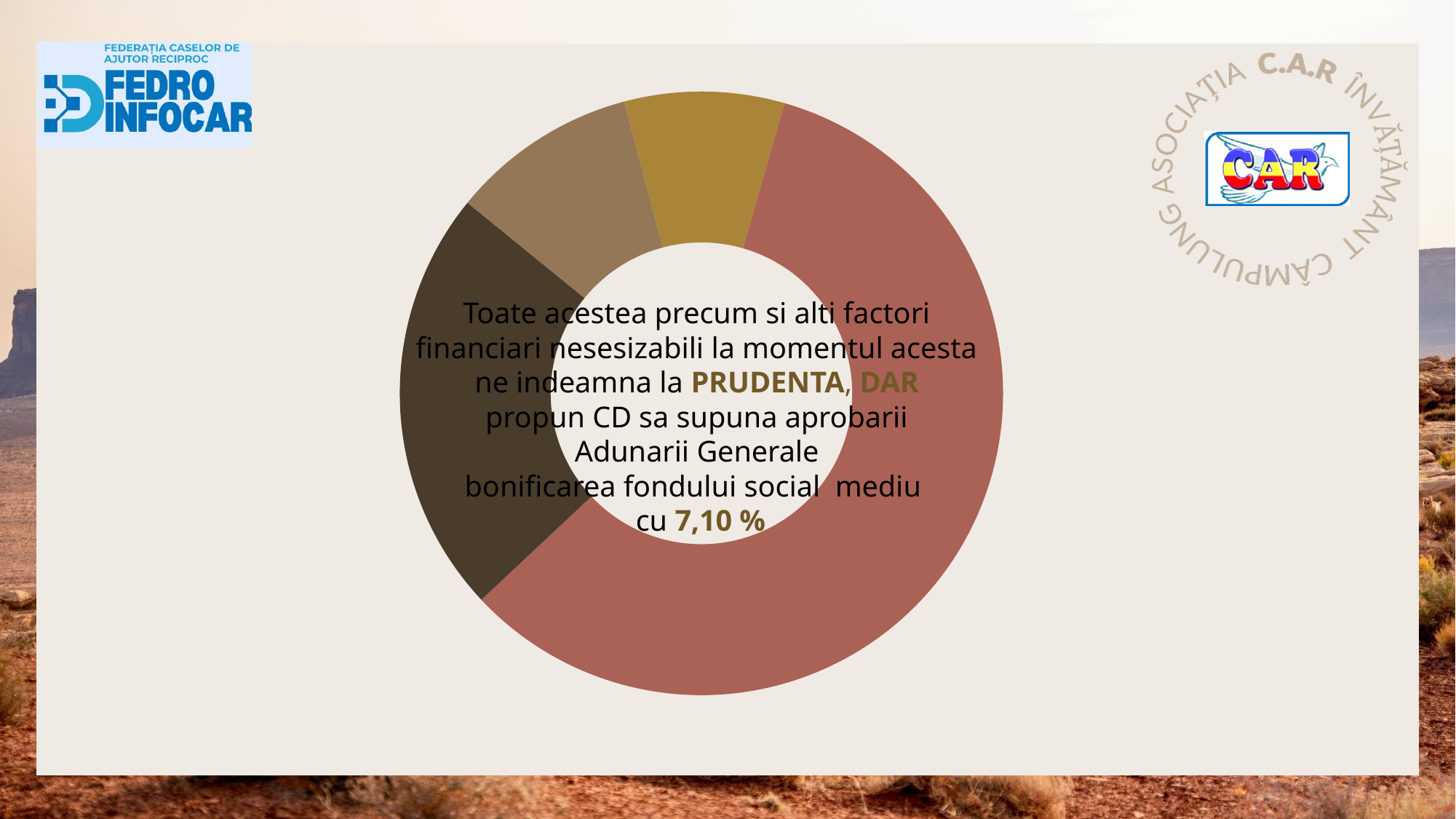
Which is larger in the doughnut chart, the red slice or the dark brown slice? red Which is larger in the doughnut chart, the dark brown slice or the gold slice? dark brown Which colour slice is the largest in the doughnut chart? red How many slices does the doughnut chart have? 4 Does the doughnut chart display a legend? No What kind of chart is shown on the slide? doughnut chart Is the red slice's share of the doughnut chart greater or less than 50%? greater Are data labels printed on the slices of the doughnut chart? No